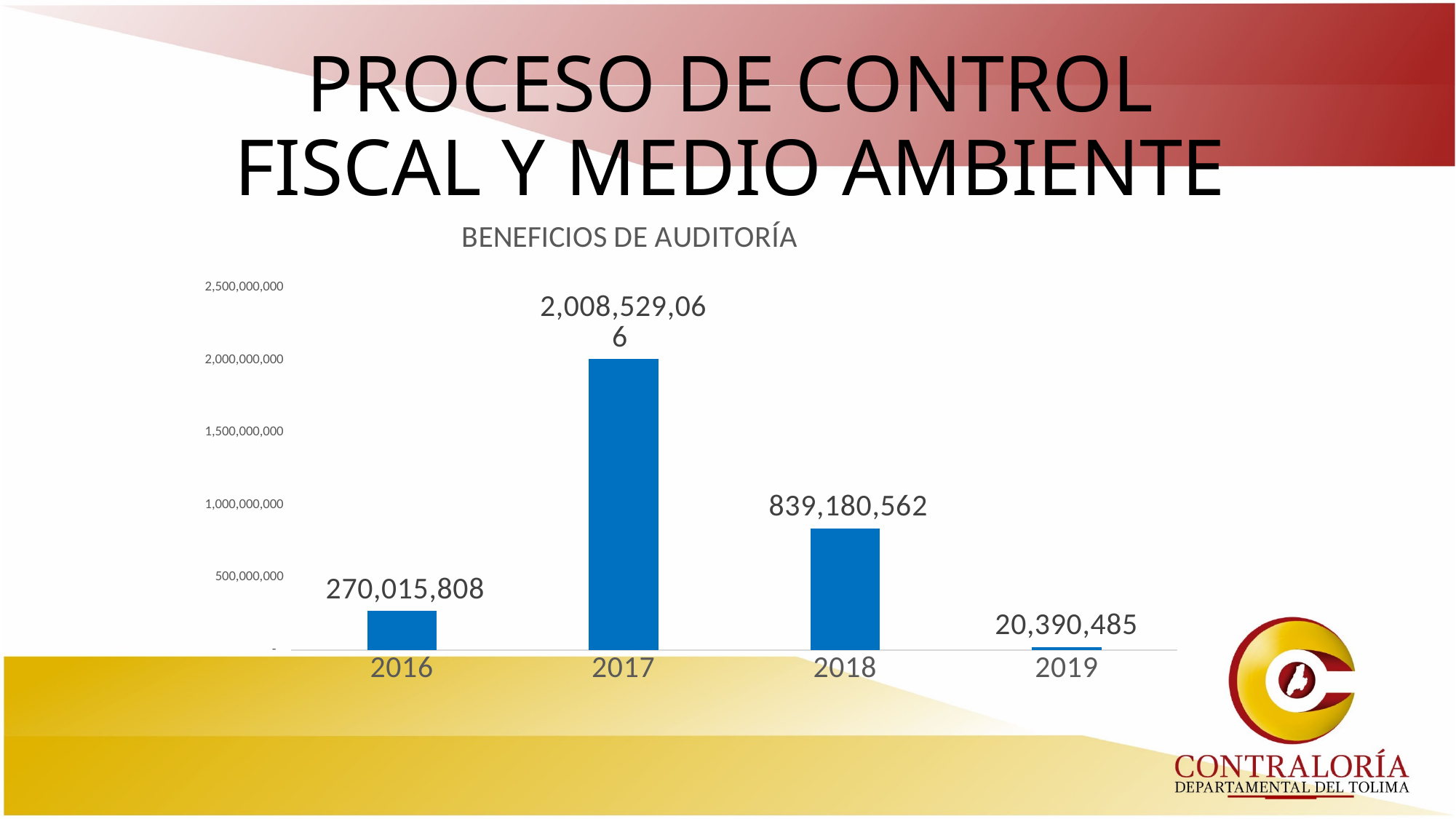
What is the value for 2018 in the BENEFICIOS DE AUDITORÍA chart? 839,180,562 Which year has the lowest value in the BENEFICIOS DE AUDITORÍA chart? 2019 What is the difference between the values for 2017 and 2018 in the BENEFICIOS DE AUDITORÍA chart? 1,169,348,504 What is the value for 2017 in the BENEFICIOS DE AUDITORÍA chart? 2,008,529,066 What kind of chart is the BENEFICIOS DE AUDITORÍA chart? bar chart What is the value for 2016 in the BENEFICIOS DE AUDITORÍA chart? 270,015,808 What is the difference between the values for 2018 and 2016 in the BENEFICIOS DE AUDITORÍA chart? 569,164,754 Which year has the highest value in the BENEFICIOS DE AUDITORÍA chart? 2017 How many years are shown on the x axis of the BENEFICIOS DE AUDITORÍA chart? 4 Which is larger in the BENEFICIOS DE AUDITORÍA chart, the value for 2016 or the value for 2018? 2018 What is the value for 2019 in the BENEFICIOS DE AUDITORÍA chart? 20,390,485 Is the value for 2018 in the BENEFICIOS DE AUDITORÍA chart greater or less than 1,000,000,000? less